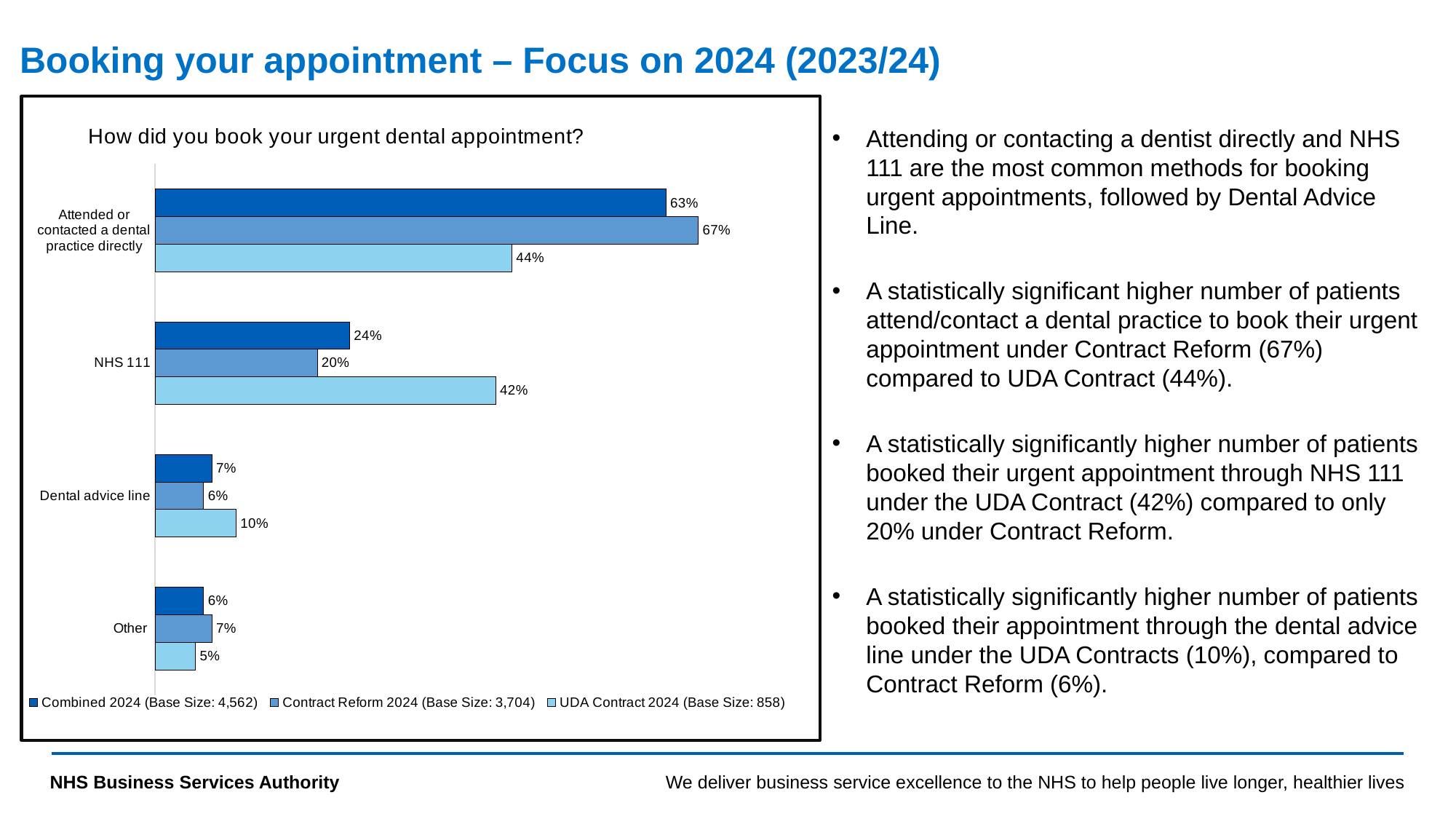
What is the value for Contract Reform 2024 for 'Attended or contacted a dental practice directly'? 67% What is the value for UDA Contract 2024 for NHS 111? 42% Which category has the lowest value for the UDA Contract 2024 series? Other What is the difference between the Contract Reform 2024 and UDA Contract 2024 values for 'Attended or contacted a dental practice directly'? 23 percentage points How many series does the legend list? 3 How many categories are shown on the chart? 4 What is the difference between the UDA Contract 2024 and Contract Reform 2024 values for NHS 111? 22 percentage points What is the value for Combined 2024 for Dental advice line? 7% What kind of chart is shown on the slide? Bar chart For NHS 111, which is larger: the Combined 2024 value or the UDA Contract 2024 value? UDA Contract 2024 Which category has the highest value for the Combined 2024 series? Attended or contacted a dental practice directly What is the value for UDA Contract 2024 for Other? 5%